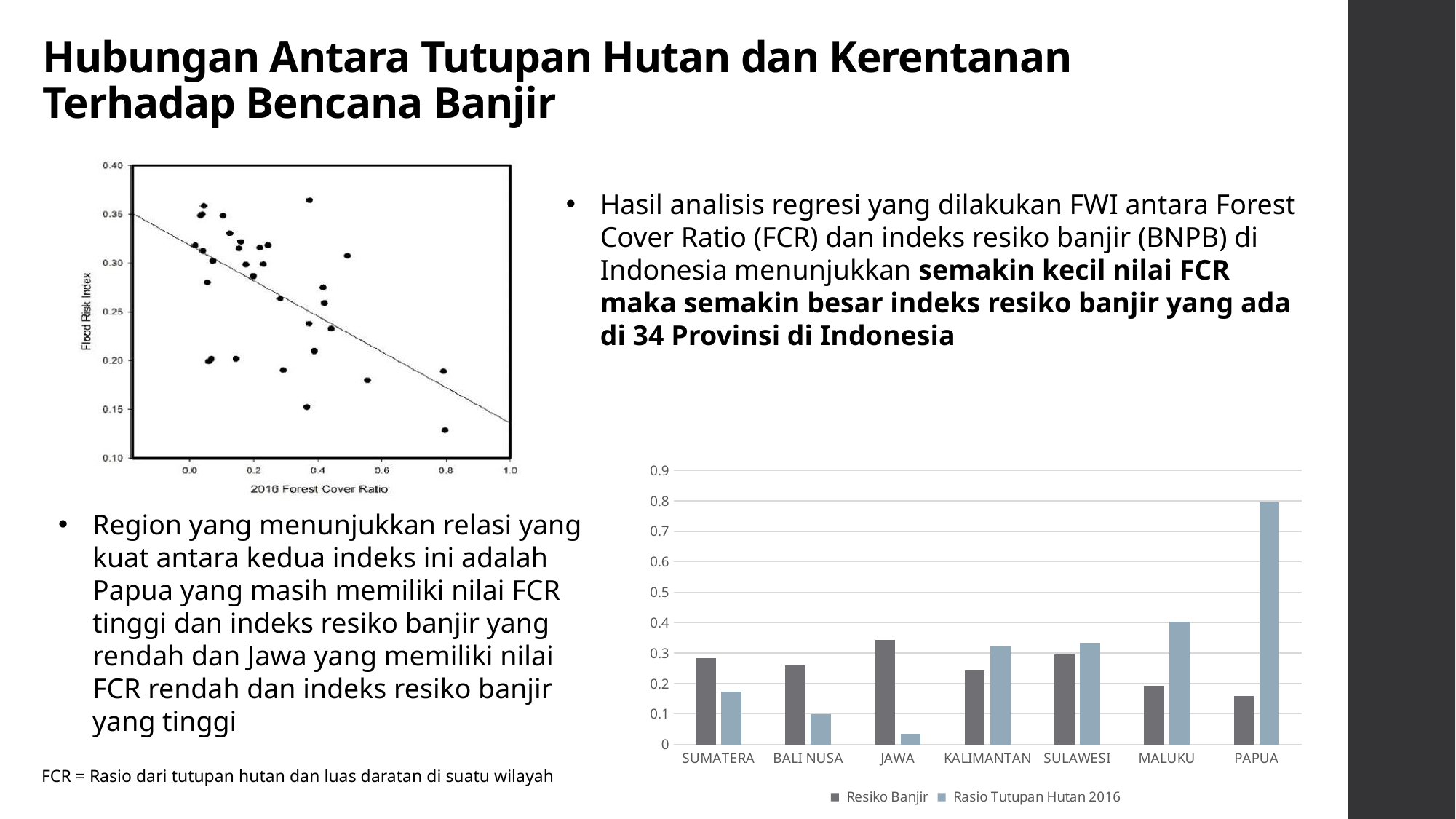
In the scatter plot on the left, does the Flood Risk Index rise or fall as the 2016 Forest Cover Ratio increases? fall In the bar chart on the right, is the Rasio Tutupan Hutan 2016 value for PAPUA greater or less than 0.7? greater In the bar chart on the right, is the Rasio Tutupan Hutan 2016 value for JAWA greater or less than 0.1? less In the bar chart on the right, which region has the lowest Rasio Tutupan Hutan 2016? JAWA In the bar chart on the right, which is larger for SUMATERA: Resiko Banjir or Rasio Tutupan Hutan 2016? Resiko Banjir In the bar chart on the right, is the Resiko Banjir value for MALUKU greater or less than 0.3? less In the bar chart on the right, which region has the highest Rasio Tutupan Hutan 2016? PAPUA How many regions are shown on the x axis of the bar chart on the right? 7 In the bar chart on the right, which region has the lowest Resiko Banjir? PAPUA In the bar chart on the right, which is larger for KALIMANTAN: Resiko Banjir or Rasio Tutupan Hutan 2016? Rasio Tutupan Hutan 2016 How many series does the legend of the bar chart on the right list? 2 In the bar chart on the right, which region has the highest Resiko Banjir? JAWA